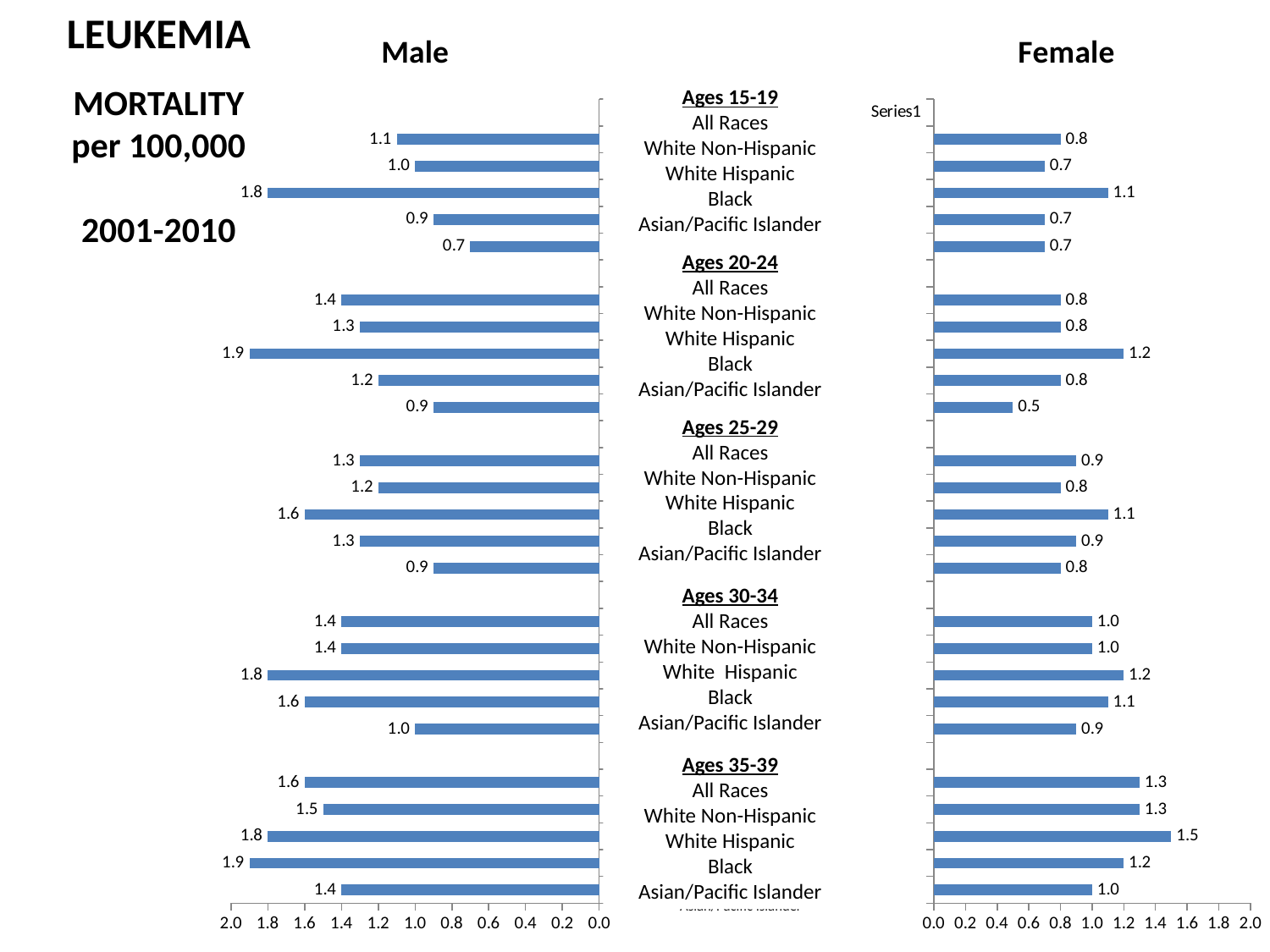
In the Female chart, what is the mortality rate for Black females aged 20-24? 0.8 In the Female chart, what is the mortality rate for All Races females aged 35-39? 1.3 In the Male chart, what is the mortality rate for White Hispanic males aged 15-19? 1.8 What type of chart is the Female chart? Bar chart In the Male chart, what is the mortality rate for Asian/Pacific Islander males aged 30-34? 1.0 Which is larger: the mortality rate for White Hispanic males aged 25-29 in the Male chart, or for White Hispanic females aged 25-29 in the Female chart? White Hispanic males aged 25-29 In the Female chart, which group has the highest mortality rate? White Hispanic, Ages 35-39 How many bars are plotted in the Male chart? 25 In the Male chart, which group has the lowest mortality rate? Asian/Pacific Islander, Ages 15-19 In the Female chart, which group has the lowest mortality rate? Asian/Pacific Islander, Ages 20-24 In the Female chart, what is the difference between the mortality rate for White Hispanic females aged 35-39 and Asian/Pacific Islander females aged 20-24? 1.0 In the Male chart, what is the difference between the mortality rate for Black males aged 35-39 and Black males aged 15-19? 1.0